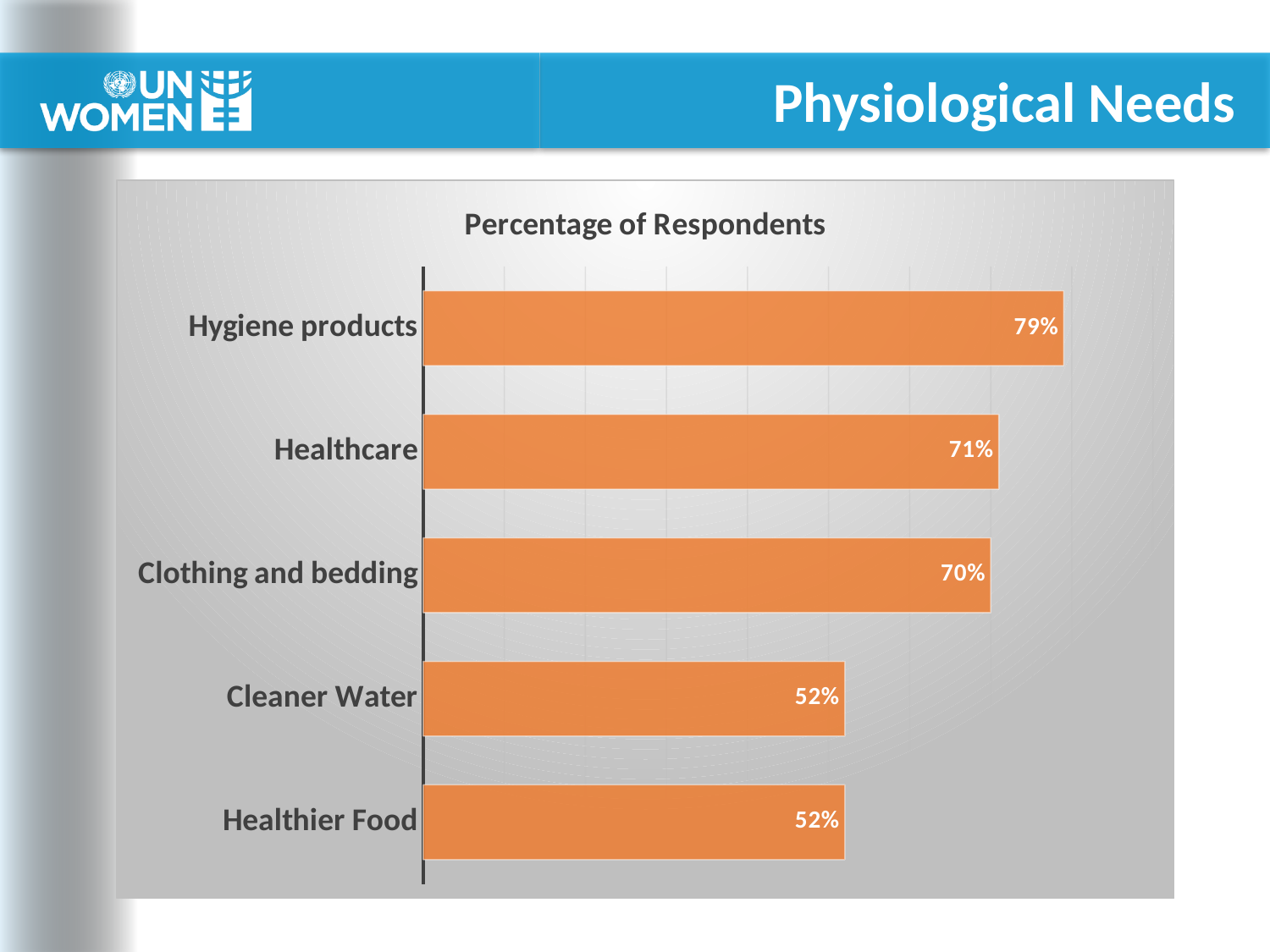
What is the difference between the values for Healthcare and Cleaner Water? 19% Which category has the highest percentage of respondents? Hygiene products What is the value for Cleaner Water? 52% What kind of chart is shown on the slide? Bar chart How many categories are shown in the chart? 5 What percentage of respondents cited Hygiene products? 79% What percentage of respondents cited Clothing and bedding? 70% What colour are the bars in the chart? Orange What is the difference between the values for Hygiene products and Healthcare? 8% What is the title of the chart? Percentage of Respondents Which is larger, the value for Healthcare or the value for Healthier Food? Healthcare What is the value for Healthcare? 71%